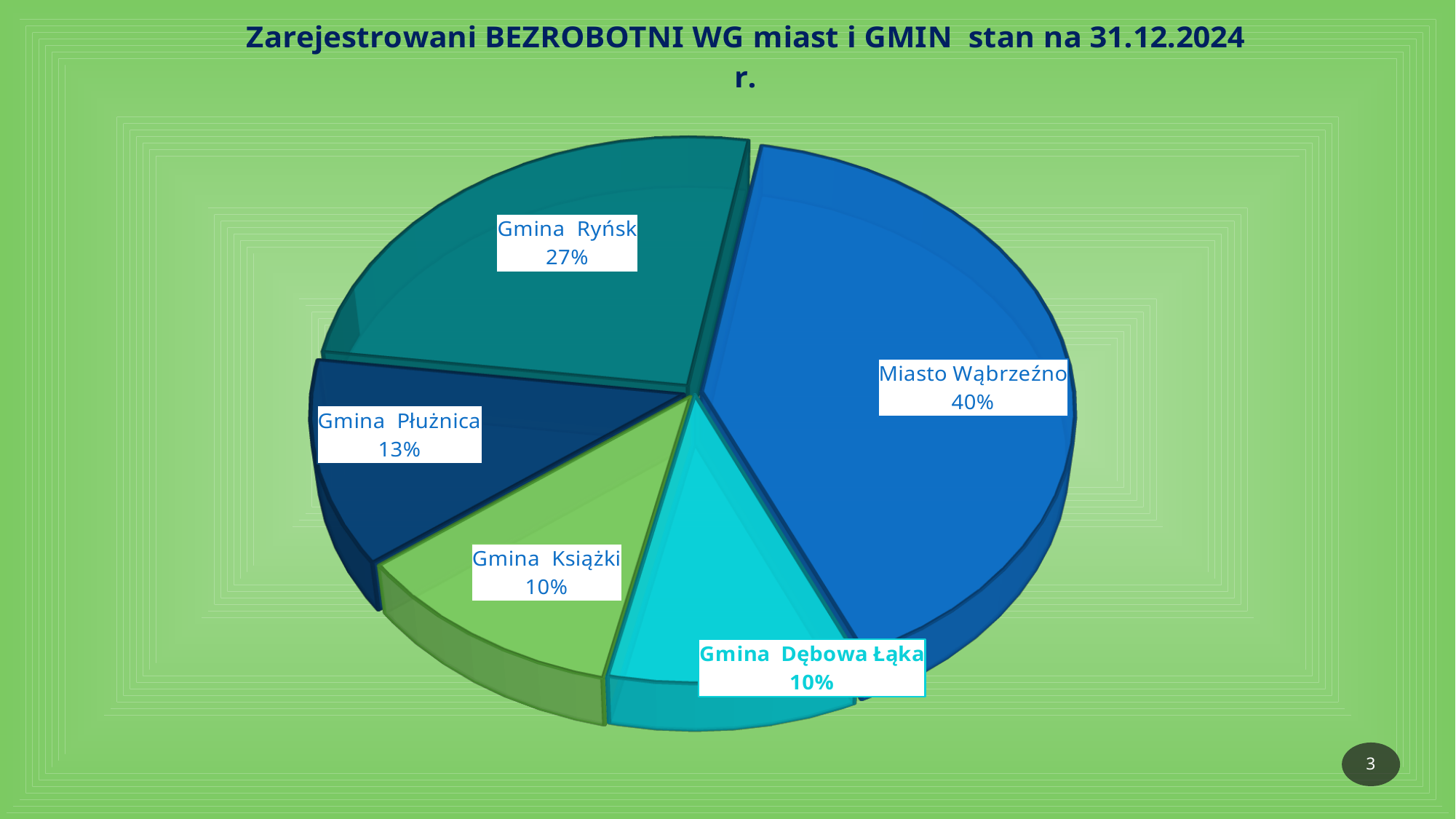
What is the combined share of Gmina Książki and Gmina Dębowa Łąka? 20% What is the difference in percentage points between Miasto Wąbrzeźno and Gmina Ryńsk? 13 What percentage is shown for Gmina Książki? 10% How many slices does the pie chart have? 5 What kind of chart is shown on the slide? Pie chart What is the title of the chart? Zarejestrowani BEZROBOTNI WG miast i GMIN stan na 31.12.2024 r. What percentage is shown for Gmina Płużnica? 13% What percentage is shown for Gmina Ryńsk? 27% What percentage is shown for Gmina Dębowa Łąka? 10% What share of registered unemployed does Miasto Wąbrzeźno account for? 40% Which category has the largest share of the pie? Miasto Wąbrzeźno Which is larger, the share for Gmina Płużnica or the share for Gmina Książki? Gmina Płużnica